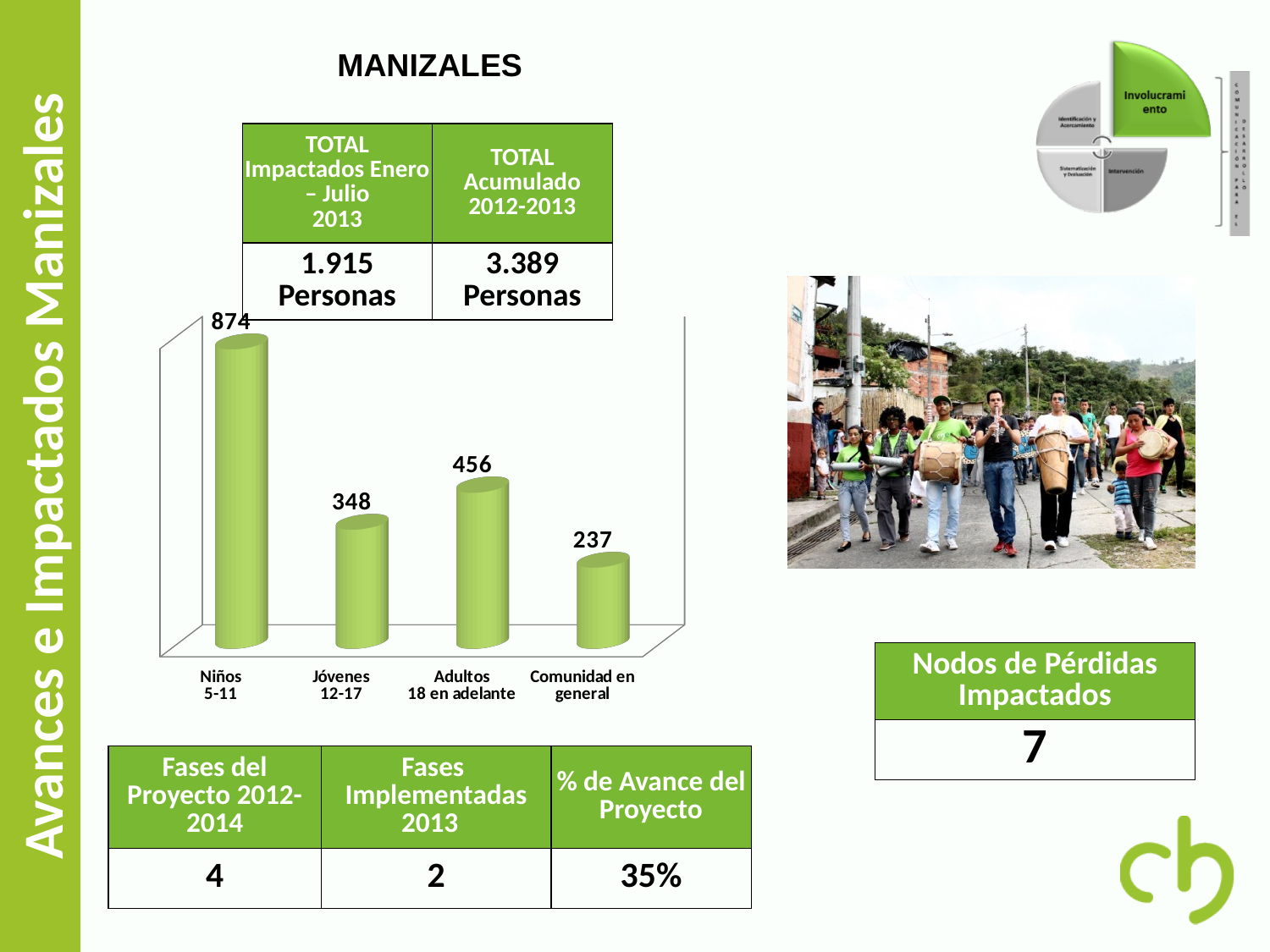
What kind of chart is shown on the slide? bar chart What is the title shown above the chart? MANIZALES Which category has the highest value in the bar chart? Niños 5-11 What is the difference between the values for Jóvenes 12-17 and Comunidad en general? 111 What is the value for Jóvenes 12-17 in the bar chart? 348 What is the value for Niños 5-11 in the bar chart? 874 What is the value for Adultos 18 en adelante in the bar chart? 456 How many categories are shown in the bar chart? 4 Which category has the lowest value in the bar chart? Comunidad en general What is the value for Comunidad en general in the bar chart? 237 What is the difference between the values for Niños 5-11 and Adultos 18 en adelante? 418 Which is larger, the value for Jóvenes 12-17 or the value for Adultos 18 en adelante? Adultos 18 en adelante